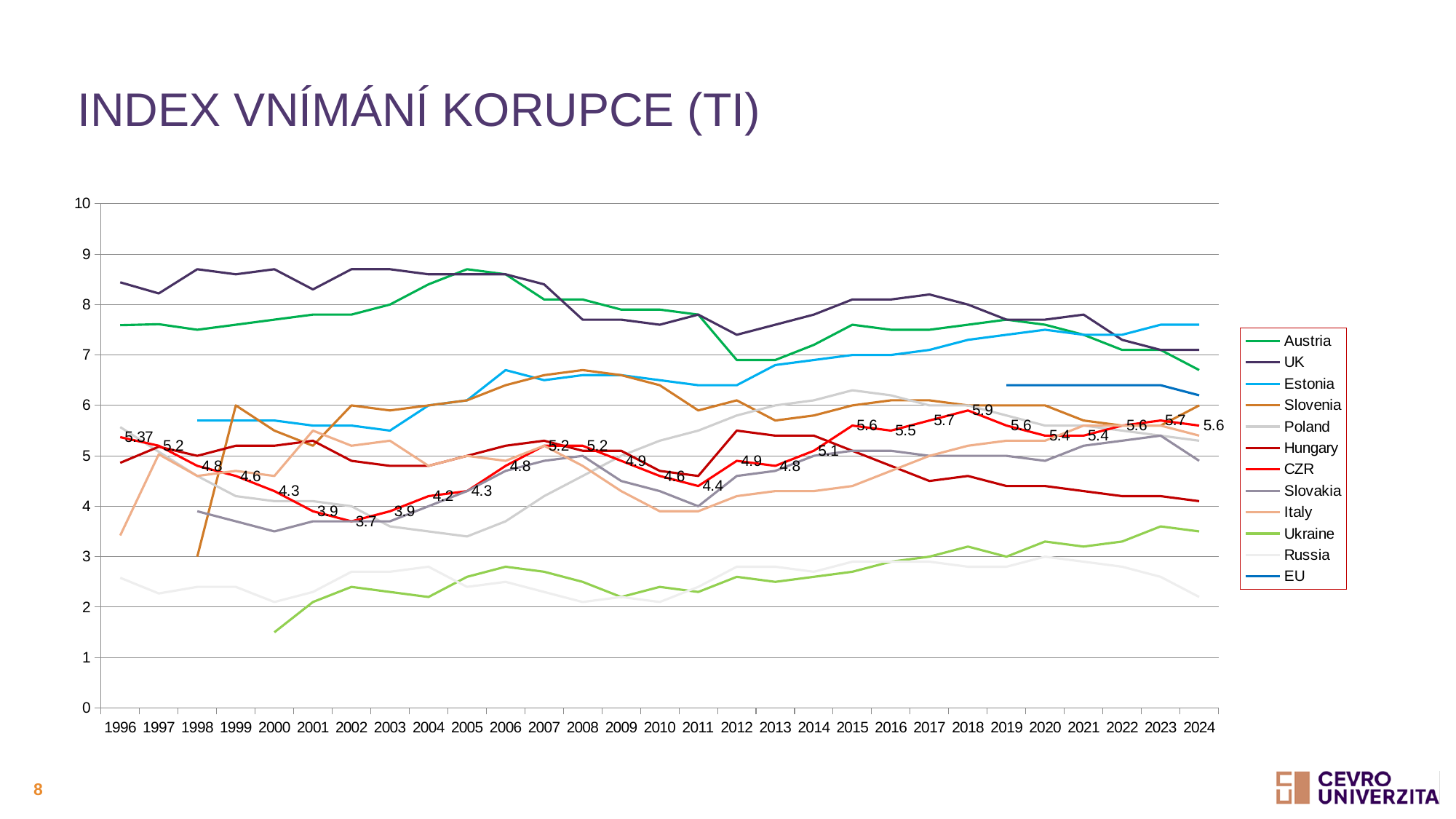
How many series does the legend list? 12 Is the value for Ukraine in 2024 greater or less than 4? less What is the labelled value for CZR in 1996? 5.37 How many years are shown on the x axis? 29 What kind of chart is shown on the slide? Line chart What is the highest labelled value on the CZR line? 5.9 What is the difference between the CZR values in 2018 and 2002? 2.2 In which year does the labelled CZR line reach its lowest value? 2002 What is the title of the slide? INDEX VNÍMÁNÍ KORUPCE (TI) What is the labelled value for CZR in 2018? 5.9 What is the labelled value for CZR in 2002? 3.7 Which has the higher value in 2024, Austria or Ukraine? Austria